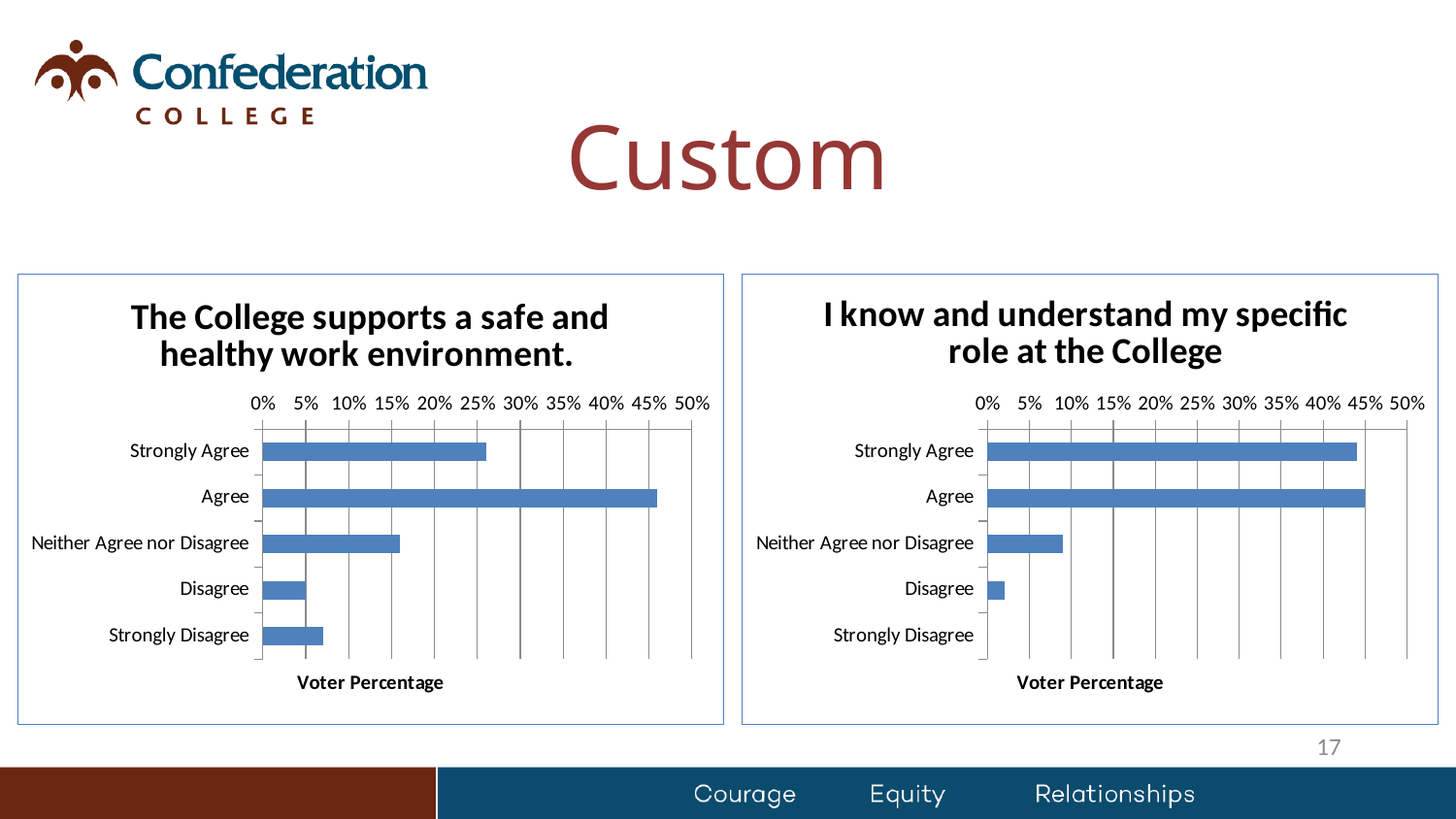
How many categories are shown in the chart "I know and understand my specific role at the College"? 5 In the chart "I know and understand my specific role at the College", which is larger: Neither Agree nor Disagree or Disagree? Neither Agree nor Disagree In the chart "The College supports a safe and healthy work environment.", which is larger: Strongly Agree or Neither Agree nor Disagree? Strongly Agree What is the x-axis title of the chart "I know and understand my specific role at the College"? Voter Percentage In the chart "I know and understand my specific role at the College", which category has the lowest value? Strongly Disagree What kind of chart is "The College supports a safe and healthy work environment."? bar chart In the chart "I know and understand my specific role at the College", is the value for Neither Agree nor Disagree greater or less than 15%? less In the chart "The College supports a safe and healthy work environment.", which category has the highest value? Agree In the chart "I know and understand my specific role at the College", is the value for Strongly Agree greater or less than 40%? greater In the chart "The College supports a safe and healthy work environment.", is the value for Agree greater or less than 40%? greater